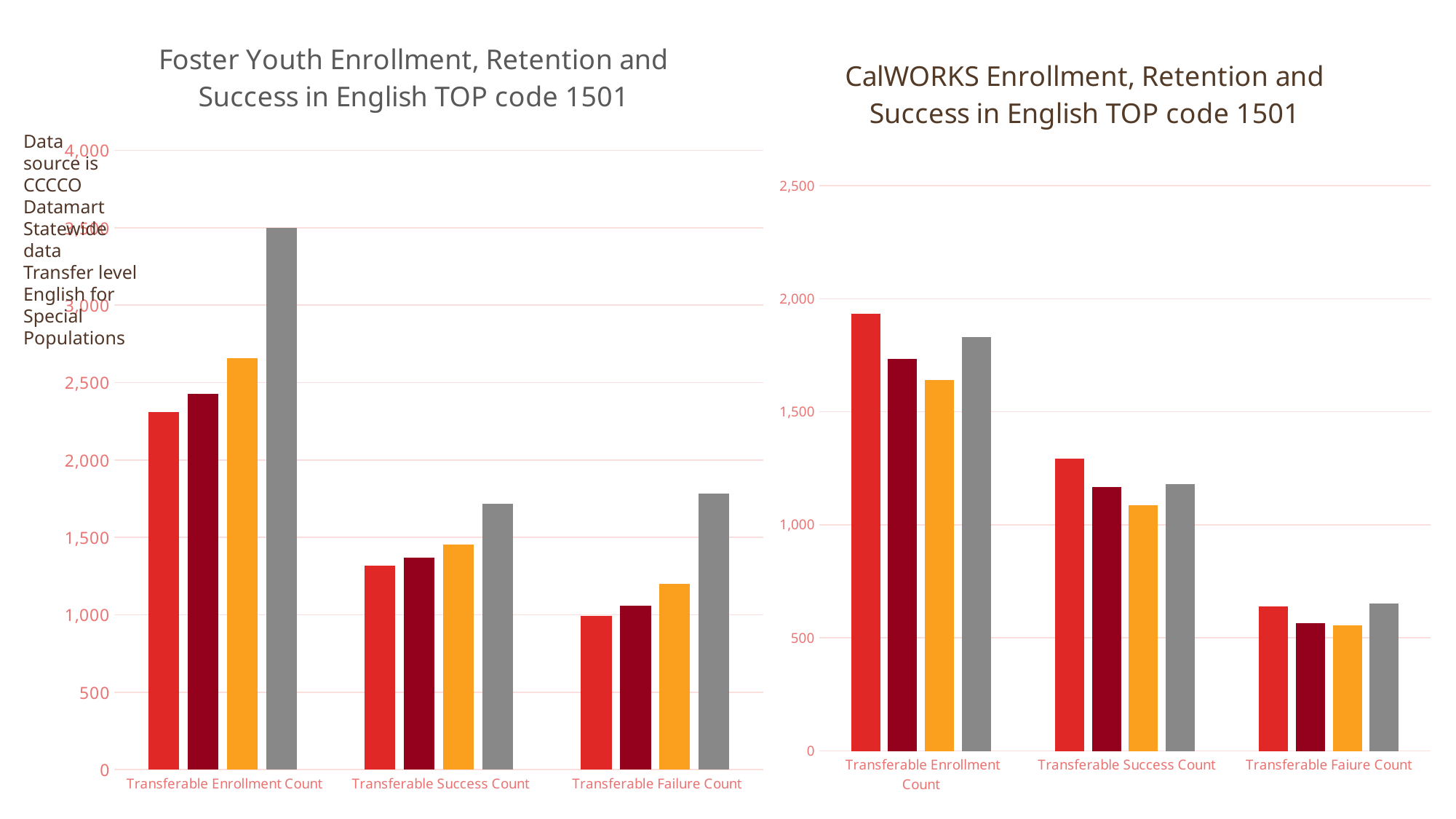
In the Foster Youth chart, which category has the tallest bar? Transferable Enrollment Count What kind of chart is the Foster Youth Enrollment, Retention and Success chart? bar chart In the CalWORKS chart, which category has the lowest bars? Transferable Faiure Count In the CalWORKS chart, is the red bar for Transferable Enrollment Count greater or less than 2,000? less How many bars are shown for each category in the CalWORKS chart? 4 In the Foster Youth chart, is the gray bar for Transferable Enrollment Count greater or less than 3,000? greater In the CalWORKS chart, is the gray bar for Transferable Faiure Count greater or less than 500? greater How many categories are shown on the x axis of the Foster Youth Enrollment, Retention and Success chart? 3 In the CalWORKS chart, for Transferable Enrollment Count, which is larger: the red bar or the orange bar? the red bar How many categories are shown on the x axis of the CalWORKS Enrollment, Retention and Success chart? 3 What is the highest value shown on the y axis of the Foster Youth chart? 4,000